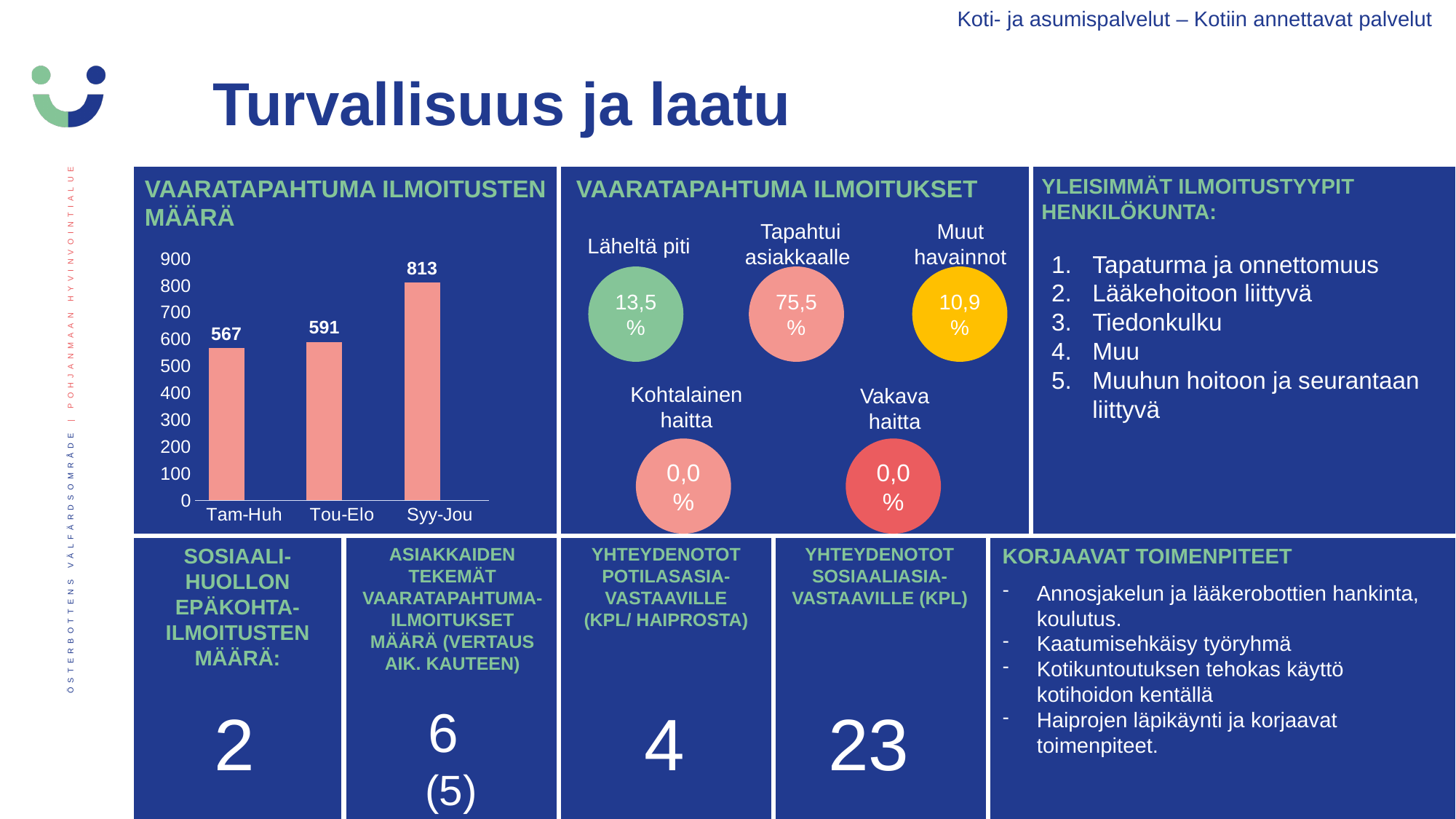
In the chart titled VAARATAPAHTUMA ILMOITUSTEN MÄÄRÄ, which period has the highest value? Syy-Jou In the chart titled VAARATAPAHTUMA ILMOITUSTEN MÄÄRÄ, what is the difference between the values for Tou-Elo and Tam-Huh? 24 What kind of chart is the one titled VAARATAPAHTUMA ILMOITUSTEN MÄÄRÄ? bar chart In the chart titled VAARATAPAHTUMA ILMOITUSTEN MÄÄRÄ, which is larger, the value for Tam-Huh or the value for Syy-Jou? Syy-Jou How many periods are shown on the x axis of the chart titled VAARATAPAHTUMA ILMOITUSTEN MÄÄRÄ? 3 In the chart titled VAARATAPAHTUMA ILMOITUSTEN MÄÄRÄ, which period has the lowest value? Tam-Huh In the chart titled VAARATAPAHTUMA ILMOITUSTEN MÄÄRÄ, is the value for Syy-Jou greater or less than 700? greater In the chart titled VAARATAPAHTUMA ILMOITUSTEN MÄÄRÄ, do the values rise or fall from Tam-Huh to Syy-Jou? rise In the chart titled VAARATAPAHTUMA ILMOITUSTEN MÄÄRÄ, what is the value for Tou-Elo? 591 In the chart titled VAARATAPAHTUMA ILMOITUSTEN MÄÄRÄ, what is the value for Syy-Jou? 813 In the chart titled VAARATAPAHTUMA ILMOITUSTEN MÄÄRÄ, what is the difference between the values for Syy-Jou and Tou-Elo? 222 In the chart titled VAARATAPAHTUMA ILMOITUSTEN MÄÄRÄ, what is the value for Tam-Huh? 567